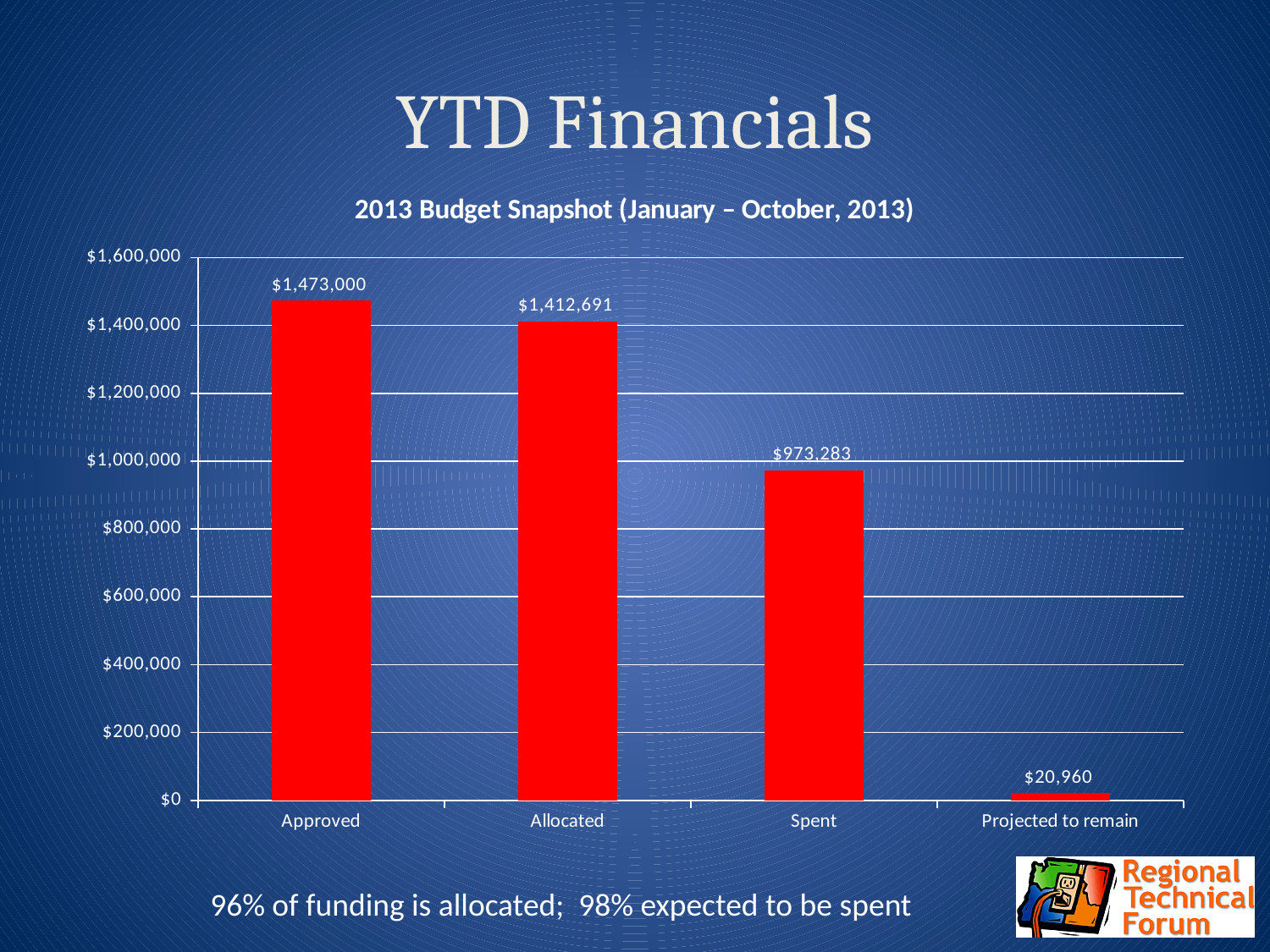
What is the value for Approved? $1,473,000 How many categories are shown on the x axis? 4 Which is larger, the value for Spent or the value for Projected to remain? Spent What is the value for Allocated? $1,412,691 Is the value for Spent greater or less than $1,000,000? less Which category has the lowest value? Projected to remain What is the value for Spent? $973,283 What is the difference between the Allocated and Spent values? $439,408 What is the value for Projected to remain? $20,960 What is the difference between the Approved and Allocated values? $60,309 What is the title of the chart? 2013 Budget Snapshot (January – October, 2013) Which category has the highest value? Approved